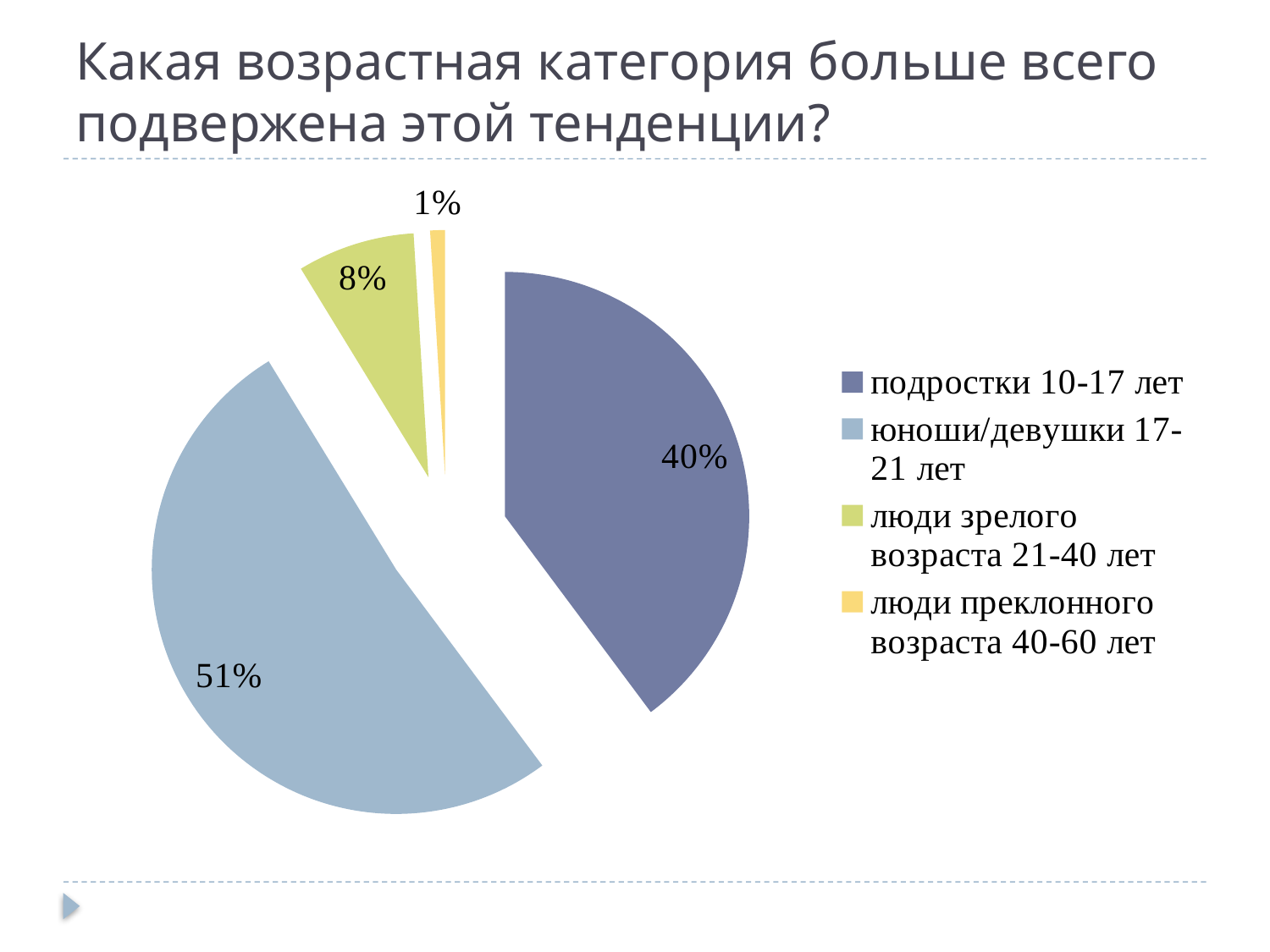
Which category has the smallest slice of the pie? люди преклонного возраста 40-60 лет What share of the pie does the category 'подростки 10-17 лет' have? 40% What type of chart is shown on the slide? pie chart What share of the pie does the category 'люди преклонного возраста 40-60 лет' have? 1% What is the combined share of 'люди зрелого возраста 21-40 лет' and 'люди преклонного возраста 40-60 лет'? 9% What share of the pie does the category 'люди зрелого возраста 21-40 лет' have? 8% What colour is the slice for 'подростки 10-17 лет'? dark blue-purple Which category has the largest slice of the pie? юноши/девушки 17-21 лет Which is larger: the slice for 'люди зрелого возраста 21-40 лет' or the slice for 'люди преклонного возраста 40-60 лет'? люди зрелого возраста 21-40 лет How many categories does the pie chart have? 4 What is the difference in percentage points between 'юноши/девушки 17-21 лет' and 'подростки 10-17 лет'? 11%